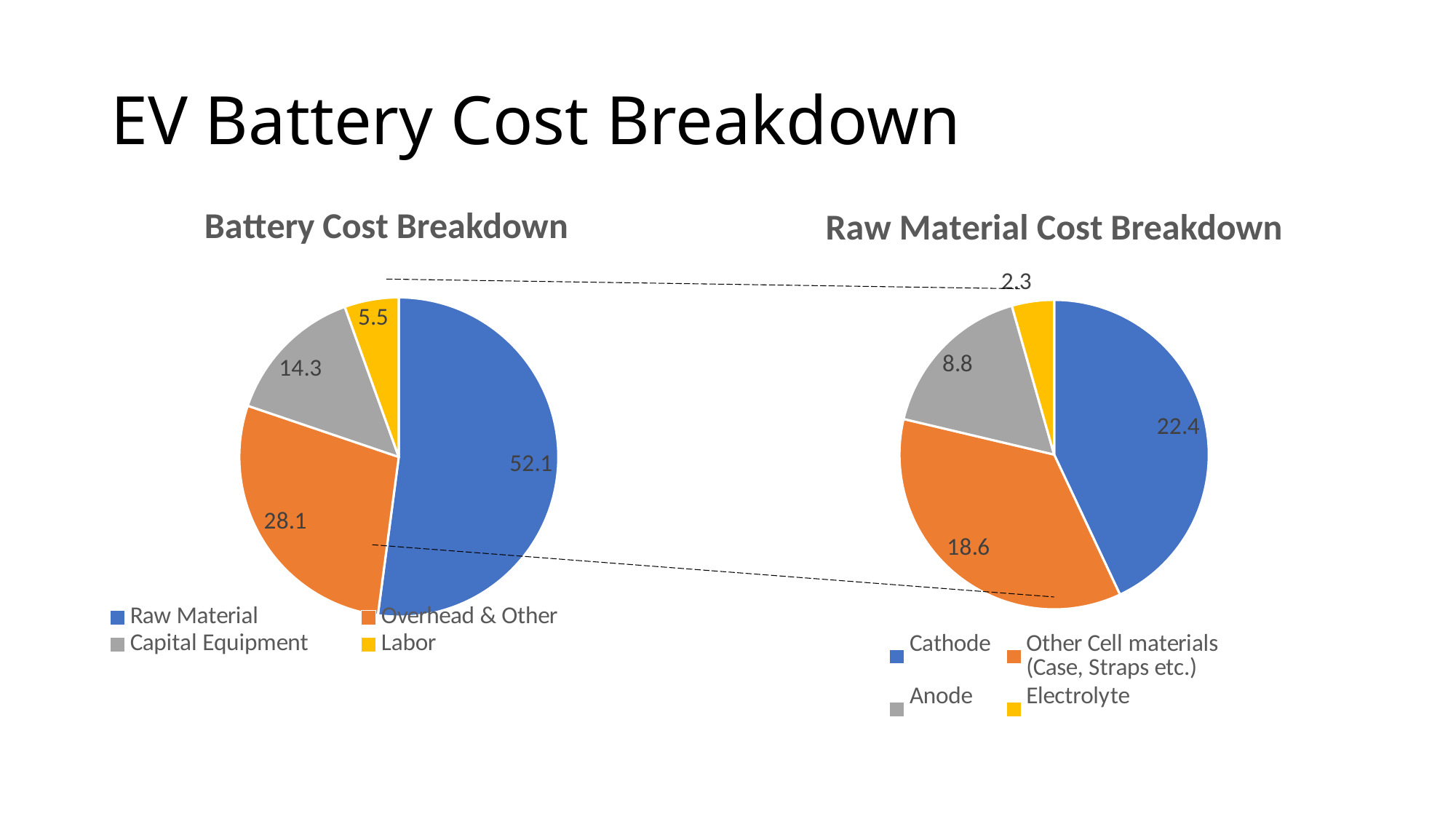
In the Battery Cost Breakdown chart, what is the difference between Overhead & Other and Capital Equipment? 13.8 In the Raw Material Cost Breakdown chart, which category has the smallest slice? Electrolyte In the Raw Material Cost Breakdown chart, what is the value for Electrolyte? 2.3 In the Battery Cost Breakdown chart, what is the value for Raw Material? 52.1 In the Battery Cost Breakdown chart, which category has the largest slice? Raw Material In the Raw Material Cost Breakdown chart, what is the difference between Cathode and Anode? 13.6 In the Raw Material Cost Breakdown chart, what colour is the Anode slice? Grey In the Raw Material Cost Breakdown chart, which is larger, Other Cell materials (Case, Straps etc.) or Anode? Other Cell materials (Case, Straps etc.) What kind of chart is the Raw Material Cost Breakdown chart? Pie chart In the Battery Cost Breakdown chart, what is the value for Labor? 5.5 How many categories does the Battery Cost Breakdown chart show? 4 In the Raw Material Cost Breakdown chart, what is the value for Cathode? 22.4